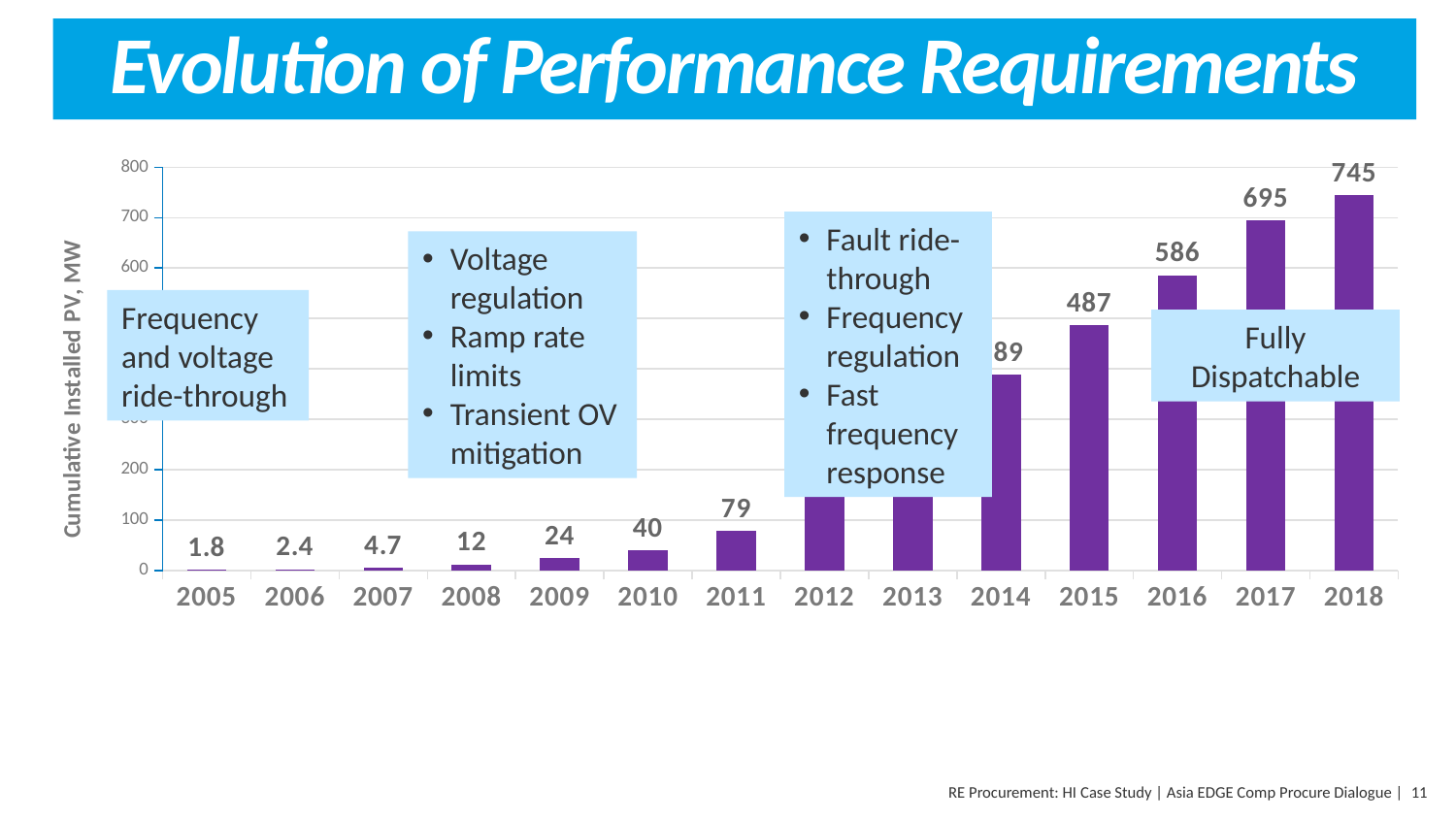
How many years are shown on the x axis of the chart? 14 What is the value shown for 2011? 79 Do the values rise or fall from 2005 to 2018? rise Which year has the larger value, 2009 or 2010? 2010 What is the cumulative installed PV value shown for 2018? 745 Is the value for 2014 greater or less than 300? greater What is the difference between the values for 2018 and 2017? 50 What is the difference between the values for 2016 and 2015? 99 Which year has the highest cumulative installed PV? 2018 What is the value shown for 2005? 1.8 Which year has the lowest cumulative installed PV? 2005 What kind of chart is shown on the slide? bar chart